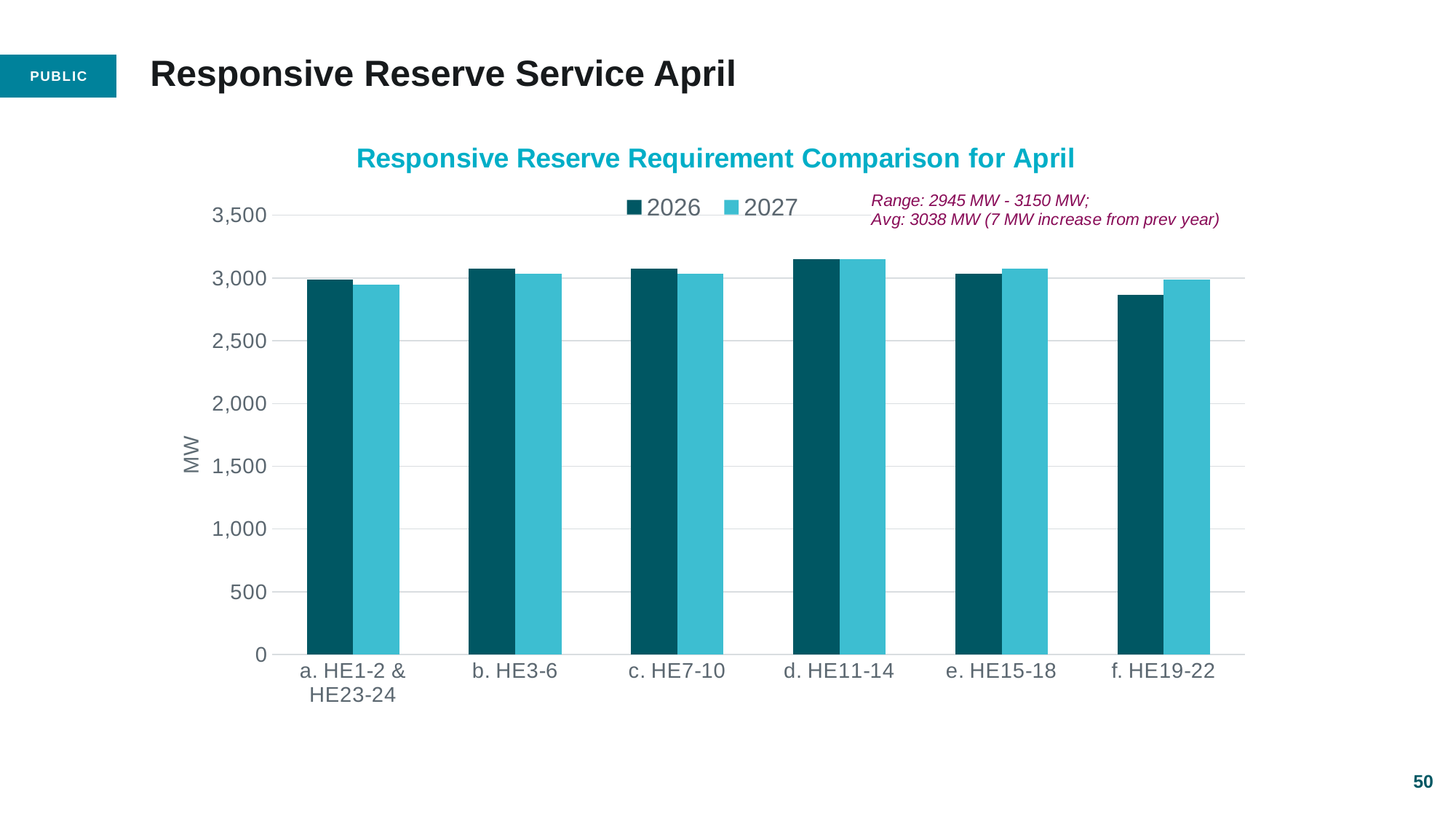
For f. HE19-22, which series has the larger value, 2026 or 2027? 2027 What is the label on the y axis? MW How many series does the legend list? 2 Is the 2026 value for f. HE19-22 greater or less than 3,000? less Is the 2027 value for a. HE1-2 & HE23-24 greater or less than 3,000? less How many hour-block categories are shown on the x axis? 6 What is the title of the chart? Responsive Reserve Requirement Comparison for April Which category has the highest 2027 value? d. HE11-14 What kind of chart is shown on the slide? Bar chart Which category has the highest 2026 value? d. HE11-14 Is the 2026 value for d. HE11-14 greater or less than 3,000? greater Which category has the lowest 2026 value? f. HE19-22